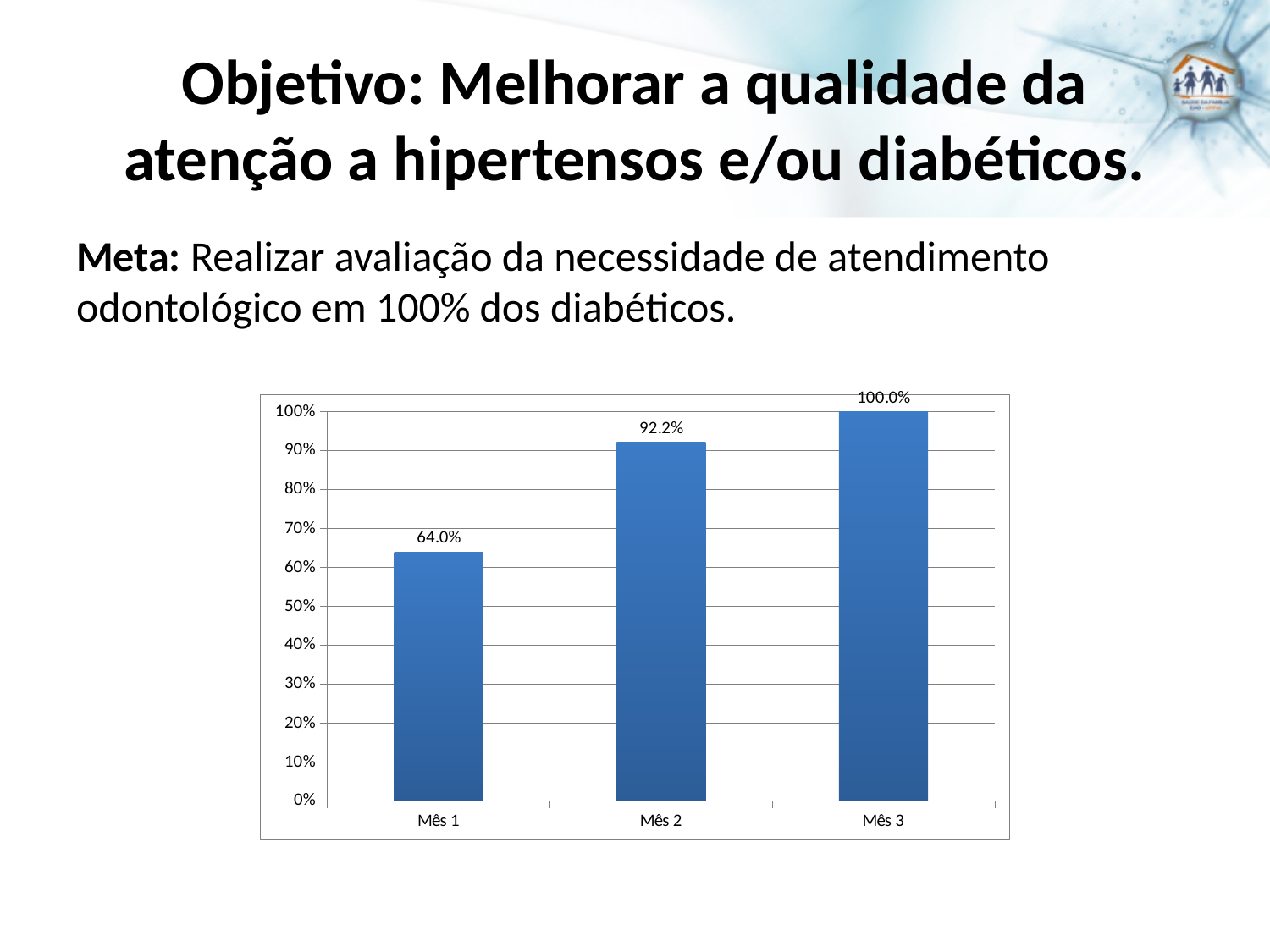
What is the difference between the values for Mês 3 and Mês 1? 36.0% Which month has the lowest value? Mês 1 What is the value for Mês 3? 100.0% Which month has the highest value? Mês 3 What kind of chart is shown on the slide? bar chart What is the value for Mês 1? 64.0% What is the value for Mês 2? 92.2% What is the difference between the values for Mês 2 and Mês 1? 28.2% Which is larger, the value for Mês 1 or the value for Mês 2? Mês 2 How many categories are shown on the x axis? 3 Is the value for Mês 1 greater or less than 70%? less Do the values rise or fall from Mês 1 to Mês 3? rise